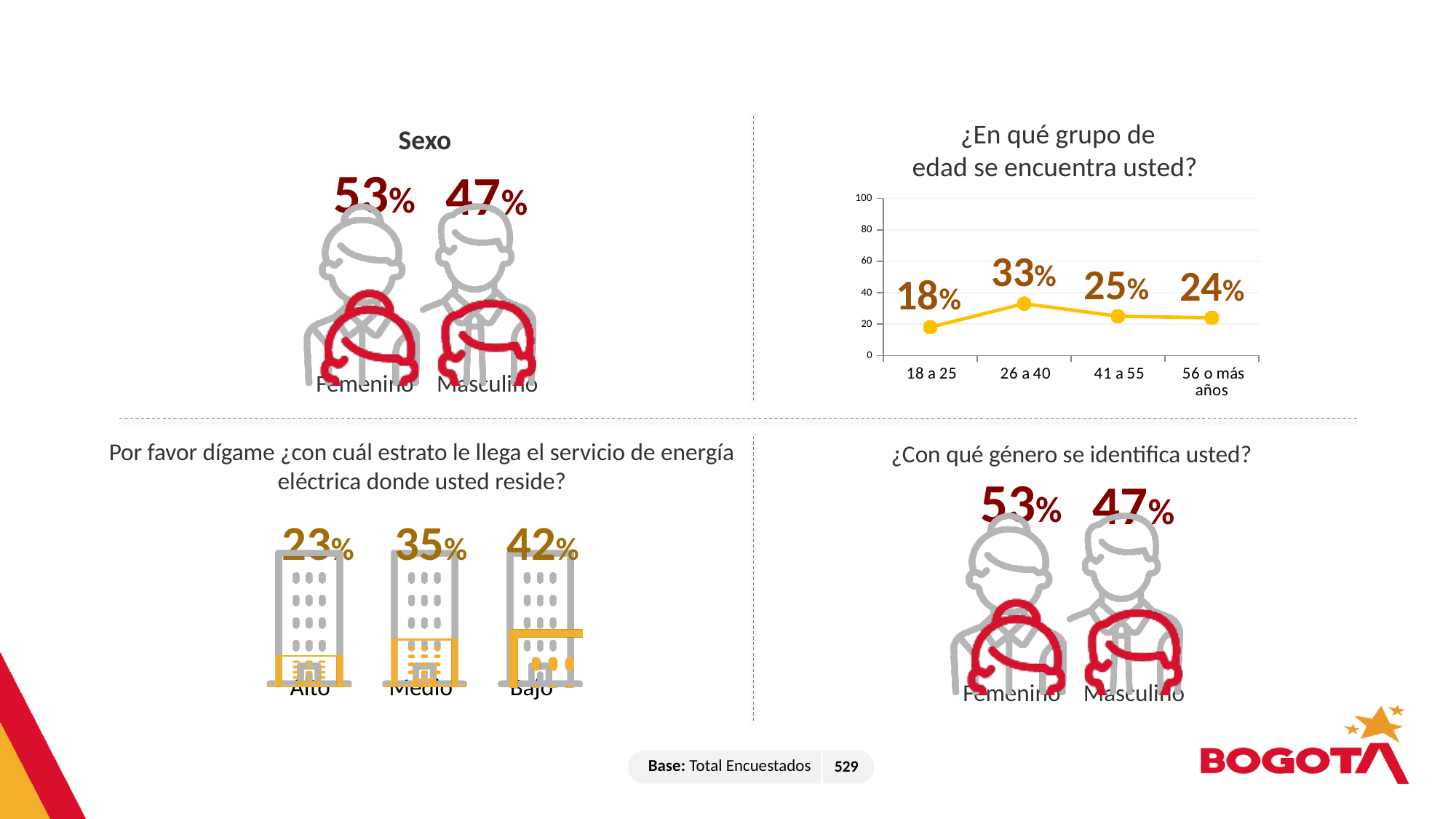
In the estrato chart at the bottom left, what is the difference between Bajo and Medio? 7% In the '¿En qué grupo de edad se encuentra usted?' chart, which age group has the highest value? 26 a 40 In the '¿Con qué género se identifica usted?' chart, which is larger, Femenino or Masculino? Femenino In the 'Sexo' chart at the top left, what percentage is shown for Femenino? 53% In the '¿En qué grupo de edad se encuentra usted?' chart, what is the value for the 26 a 40 age group? 33% In the '¿En qué grupo de edad se encuentra usted?' chart, which age group has the lowest value? 18 a 25 In the estrato chart at the bottom left, which estrato has the lowest percentage? Alto What kind of chart is the '¿En qué grupo de edad se encuentra usted?' chart? Line chart In the 'Sexo' chart at the top left, what percentage is shown for Masculino? 47% In the '¿En qué grupo de edad se encuentra usted?' chart, what is the difference between the 26 a 40 and 18 a 25 values? 15% In the estrato chart at the bottom left, what percentage is shown for Bajo? 42% In the '¿En qué grupo de edad se encuentra usted?' chart, how many age groups are plotted? 4